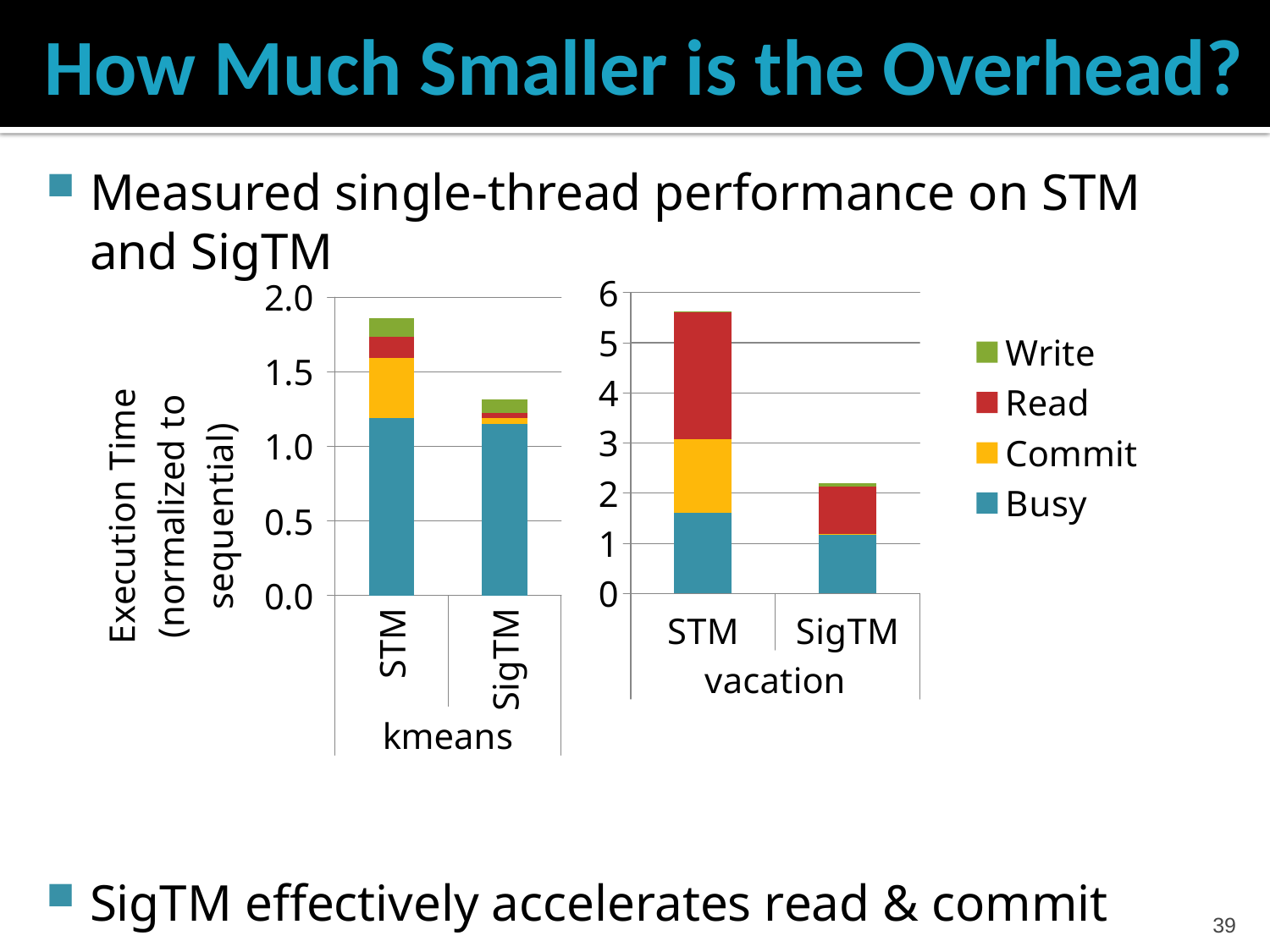
In the vacation chart on the right, how many bars are plotted? 2 Which legend entry is shown in red? Read In the vacation chart, is the total value for STM greater or less than 5? greater In the vacation chart, which bar has the highest total execution time? STM In the kmeans chart, is the total value for STM greater or less than 1.5? greater In the vacation chart, is the total value for SigTM greater or less than 3? less In the vacation chart, which bar is taller, STM or SigTM? STM What kind of chart is the kmeans chart on the left? stacked bar chart What is the y-axis title of the kmeans chart? Execution Time (normalized to sequential) How many series does the legend list? 4 In the kmeans chart, which bar is taller, STM or SigTM? STM